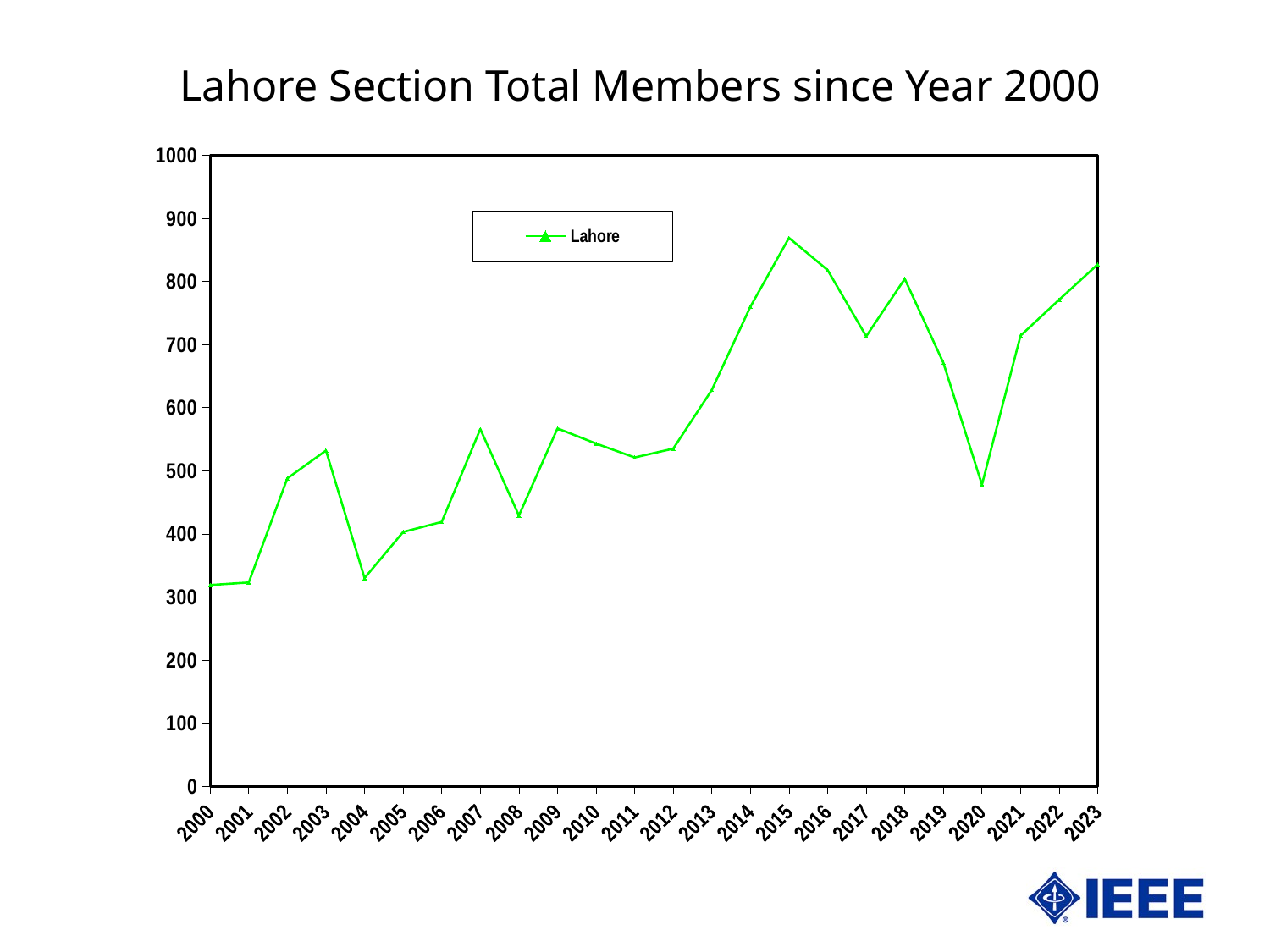
Is the value for 2023 greater or less than 800? greater How many years are plotted along the x axis? 24 What kind of chart is shown on the slide? Line chart What is the title of the chart? Lahore Section Total Members since Year 2000 Is the value for 2020 greater or less than 500? less Which year has the larger value, 2007 or 2008? 2007 Which year has the larger value, 2015 or 2018? 2015 Is the value for 2004 greater or less than 400? less How many series does the legend list? 1 Do the values rise or fall from 2020 to 2023? rise In which year is the number of members highest? 2015